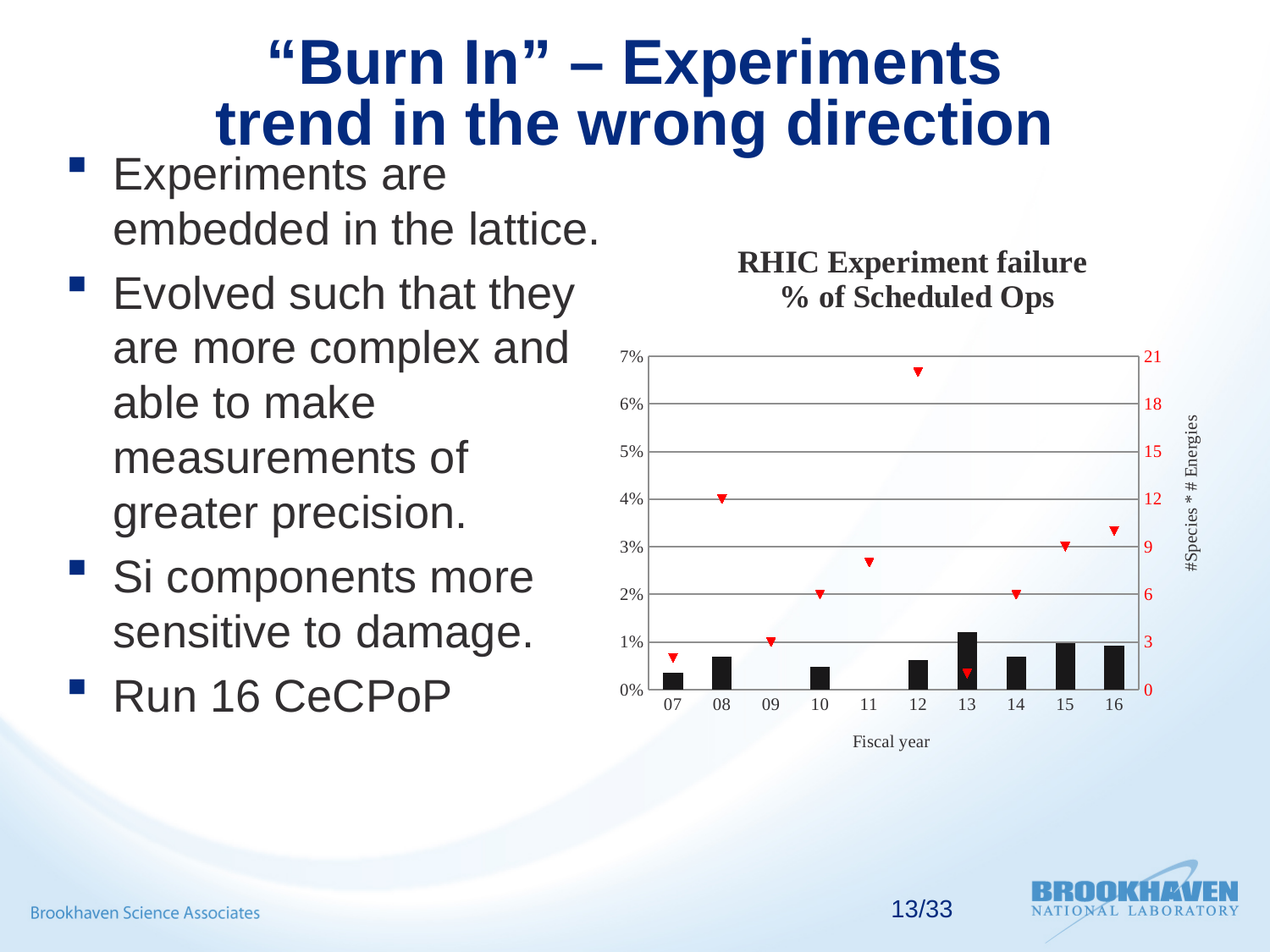
What is the title of the chart on the slide? RHIC Experiment failure % of Scheduled Ops Is the #Species * # Energies marker for fiscal year 12 greater or less than 18? greater Is the failure percentage bar for fiscal year 07 greater or less than 1%? less In which fiscal year is the #Species * # Energies marker highest? 12 Which has the larger failure percentage bar, fiscal year 13 or fiscal year 08? 13 What is the label of the right-hand vertical axis of the chart? #Species * # Energies How many fiscal years are shown on the x axis of the RHIC Experiment failure chart? 10 What is the #Species * # Energies value marked for fiscal year 08? 12 Is the #Species * # Energies marker for fiscal year 16 greater or less than 9? greater What kind of chart is used to show the RHIC experiment failure percentage by fiscal year? bar chart Which fiscal year has the highest experiment failure percentage bar? 13